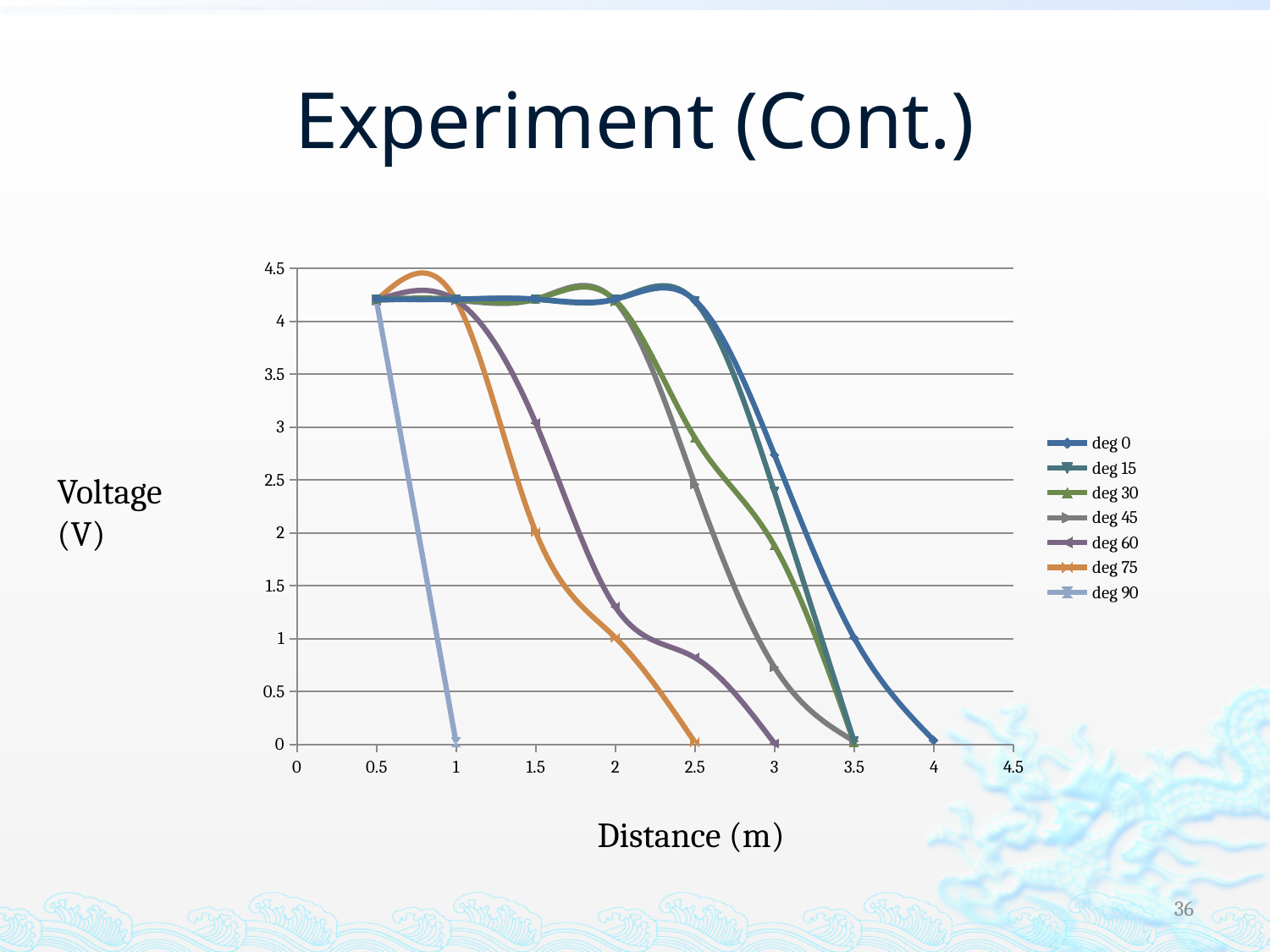
What kind of chart is shown on the slide? line chart Do the voltage values generally rise or fall as distance increases? fall How many series does the legend list? 7 Is the value for deg 90 at a distance of 1 m greater or less than 0.5? less At a distance of 3 m, which series has the larger value, deg 0 or deg 45? deg 0 Which series drops to zero voltage at the smallest distance? deg 90 What is the label of the y axis? Voltage (V) Is the value for deg 0 at a distance of 3 m greater or less than 2? greater What is the label of the x axis? Distance (m) Is the value for deg 30 at a distance of 3 m greater or less than 2? less